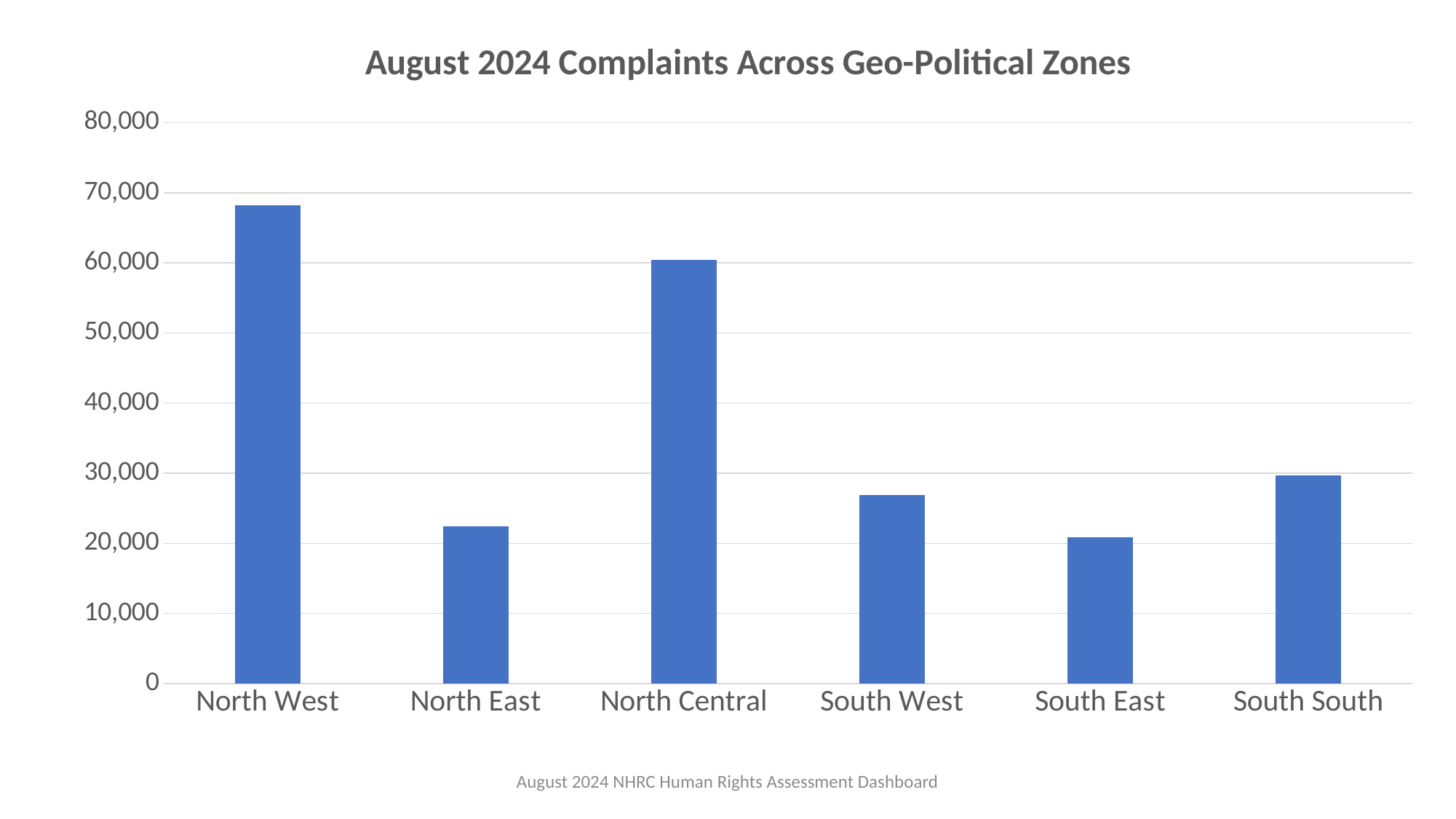
Which has more complaints, North West or North Central? North West Is the value for South East greater or less than 30,000? less Which zone has the lowest number of complaints? South East Which zone has the highest number of complaints? North West Which has more complaints, South West or North East? South West Is the value for South South greater or less than 20,000? greater What source is cited below the chart? August 2024 NHRC Human Rights Assessment Dashboard Is the value for North Central greater or less than 70,000? less What kind of chart is shown on the slide? Bar chart What is the title of the chart? August 2024 Complaints Across Geo-Political Zones How many geo-political zones are shown on the x axis? 6